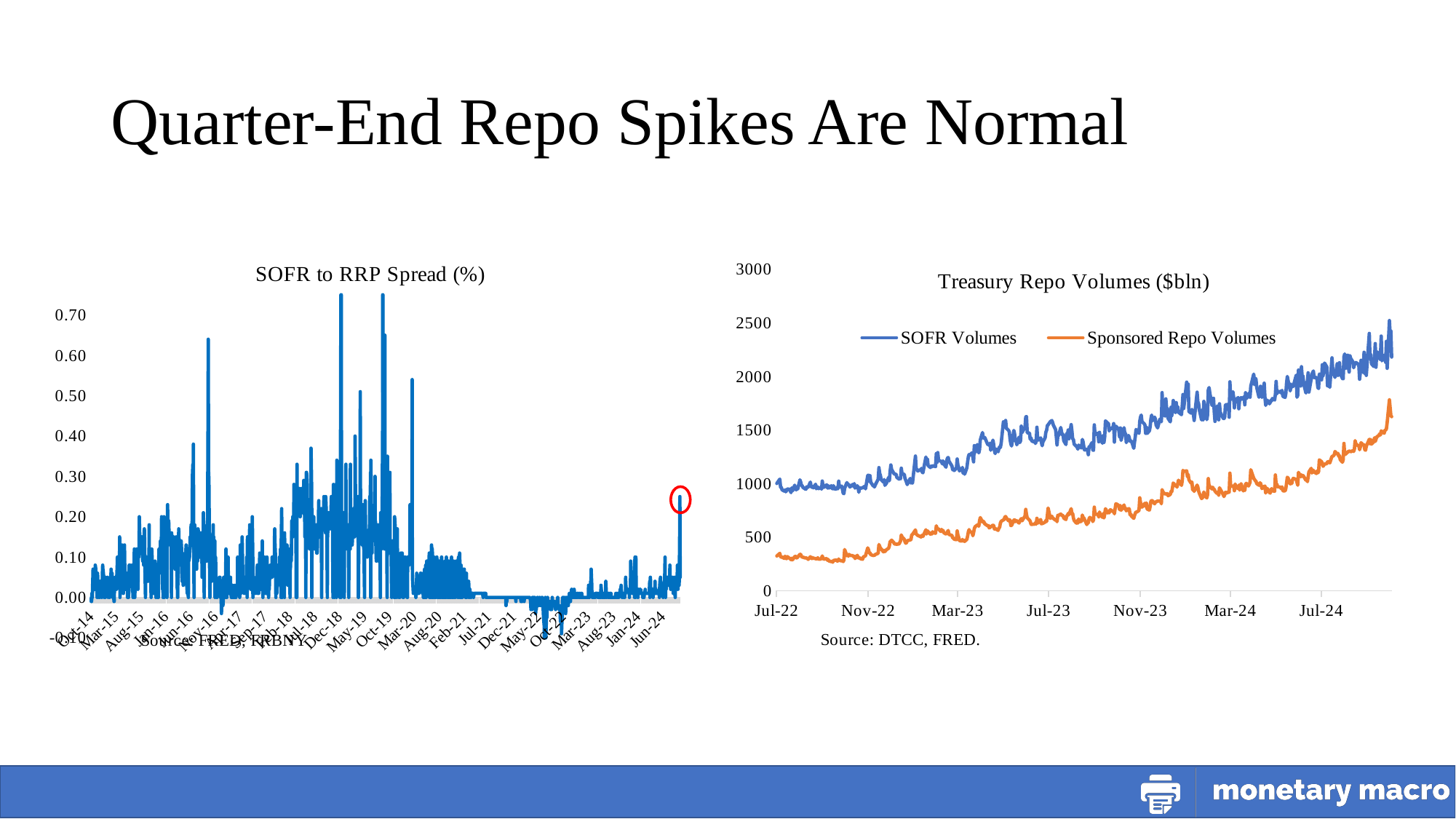
What kind of chart is the 'Treasury Repo Volumes ($bln)' chart on the right? line chart In the 'SOFR to RRP Spread (%)' chart, is the value around Jul-21 greater or less than 0.10? less In the 'Treasury Repo Volumes ($bln)' chart, is the value of Sponsored Repo Volumes at Jul-22 greater or less than 500? less How many series does the legend of the 'Treasury Repo Volumes ($bln)' chart list? 2 In the 'Treasury Repo Volumes ($bln)' chart, which series is higher at Jul-24, SOFR Volumes or Sponsored Repo Volumes? SOFR Volumes In the 'Treasury Repo Volumes ($bln)' chart, is the value of SOFR Volumes at Mar-24 greater or less than 1500? greater In the 'Treasury Repo Volumes ($bln)' chart, do Sponsored Repo Volumes rise or fall over the period shown? rise What is the title of the chart on the left of the slide? SOFR to RRP Spread (%) What colour is the Sponsored Repo Volumes line in the 'Treasury Repo Volumes ($bln)' chart? orange In the 'Treasury Repo Volumes ($bln)' chart, do SOFR Volumes rise or fall from Jul-22 to Jul-24? rise